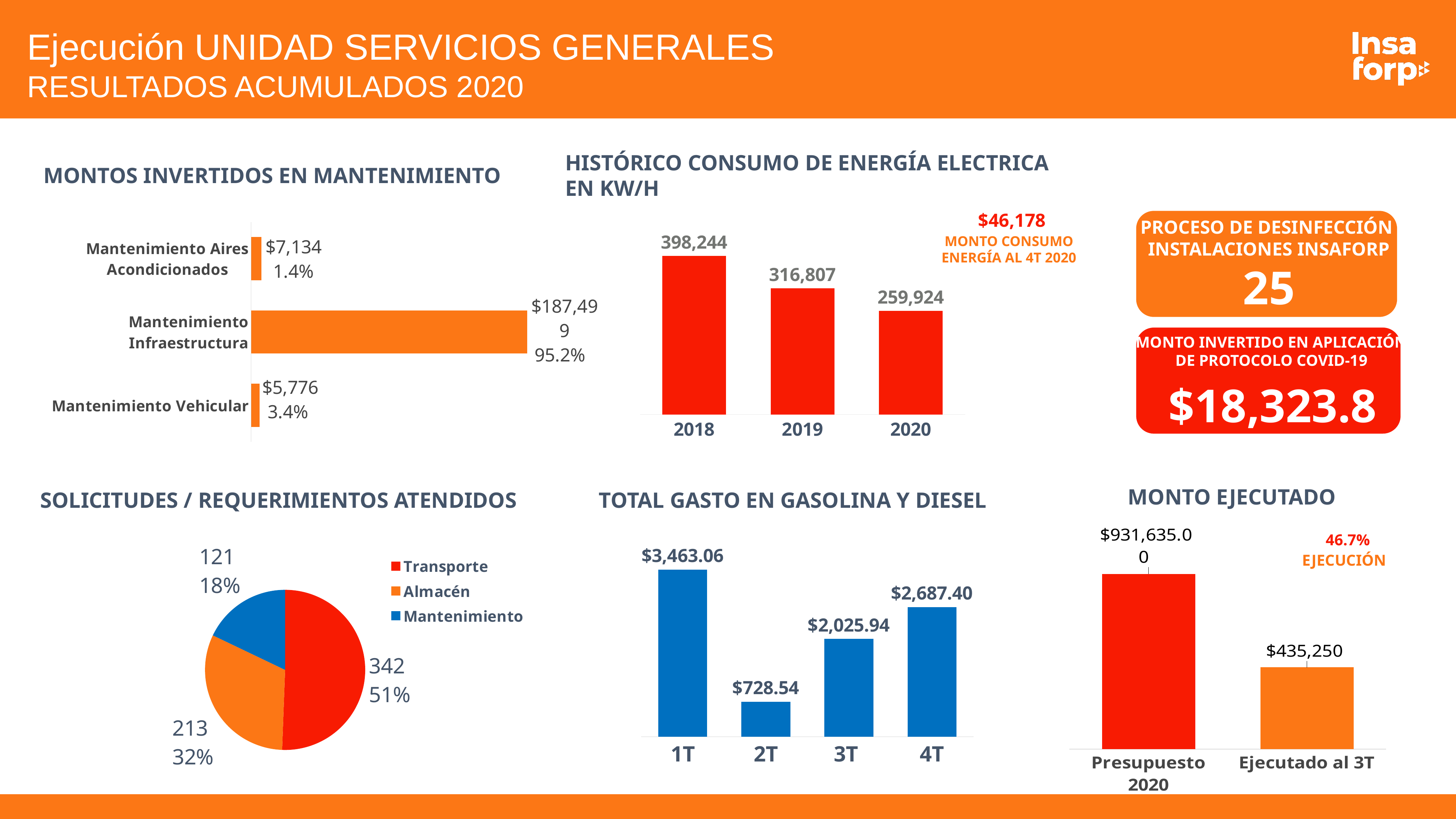
In the 'SOLICITUDES / REQUERIMIENTOS ATENDIDOS' pie chart, what is the value for Almacén? 213 In the 'SOLICITUDES / REQUERIMIENTOS ATENDIDOS' pie chart, what share does Transporte have? 51% In the 'TOTAL GASTO EN GASOLINA Y DIESEL' chart, which quarter has the highest value? 1T In the 'MONTO EJECUTADO' chart, which is larger, Presupuesto 2020 or Ejecutado al 3T? Presupuesto 2020 What kind of chart is 'MONTOS INVERTIDOS EN MANTENIMIENTO'? Bar chart In the 'MONTOS INVERTIDOS EN MANTENIMIENTO' chart, what is the value for Mantenimiento Infraestructura? $187,499 In the 'HISTÓRICO CONSUMO DE ENERGÍA ELECTRICA EN KW/H' chart, what is the value for 2019? 316,807 In the 'HISTÓRICO CONSUMO DE ENERGÍA ELECTRICA EN KW/H' chart, what is the difference between the 2018 and 2019 values? 81,437 In the 'MONTOS INVERTIDOS EN MANTENIMIENTO' chart, which category has the lowest value? Mantenimiento Vehicular In the 'HISTÓRICO CONSUMO DE ENERGÍA ELECTRICA EN KW/H' chart, do the values rise or fall from 2018 to 2020? Fall In the 'SOLICITUDES / REQUERIMIENTOS ATENDIDOS' pie chart, how many entries does the legend list? 3 In the 'TOTAL GASTO EN GASOLINA Y DIESEL' chart, what is the difference between 1T and 2T? $2,734.52